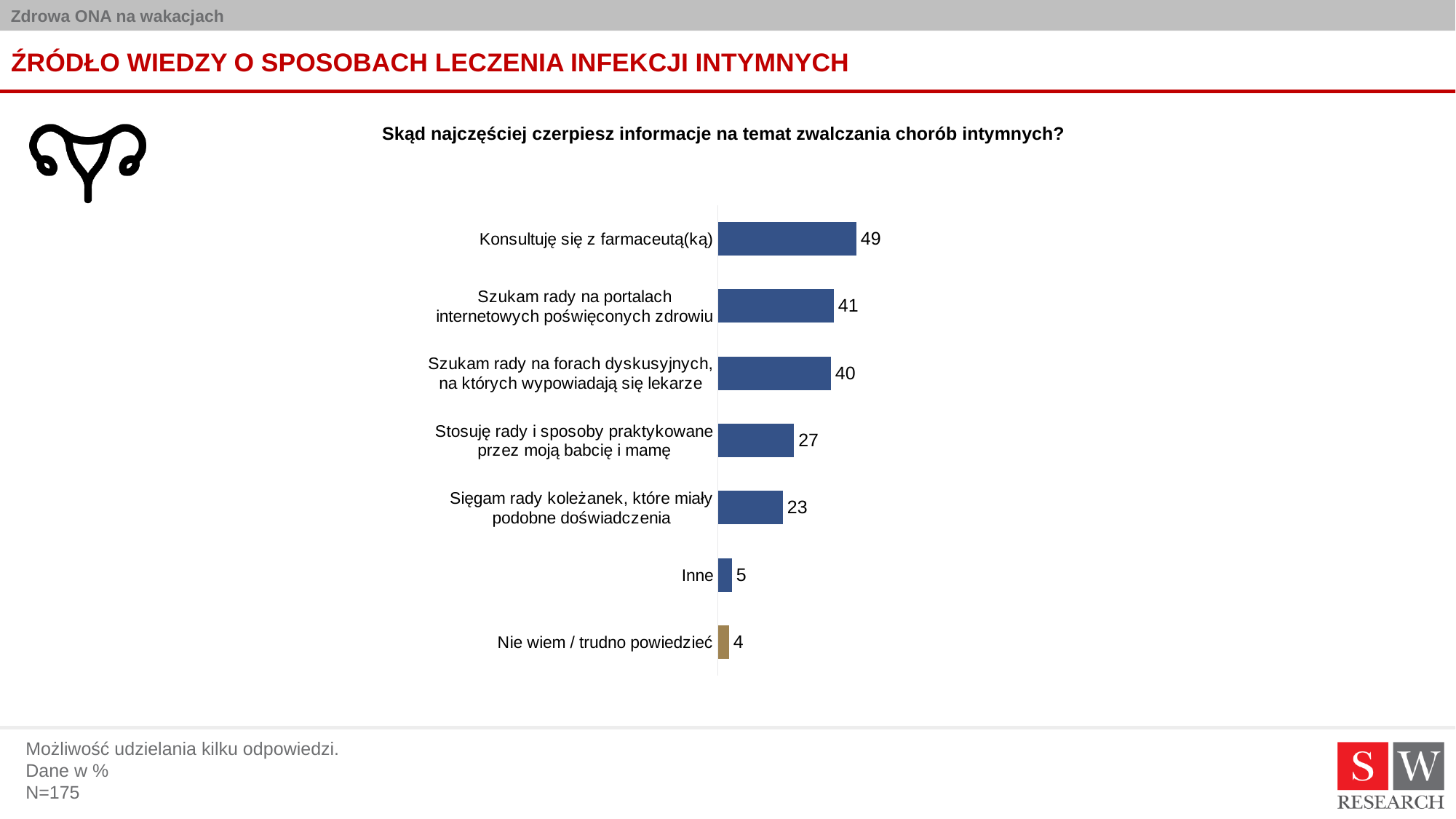
How many categories are shown in the chart? 7 What is the difference between the values for "Konsultuję się z farmaceutą(ką)" and "Szukam rady na portalach internetowych poświęconych zdrowiu"? 8 Which category's bar is shown in a different colour from the others? Nie wiem / trudno powiedzieć What value is shown for "Sięgam rady koleżanek, które miały podobne doświadczenia"? 23 Which category has the highest value? Konsultuję się z farmaceutą(ką) Which category has the lowest value? Nie wiem / trudno powiedzieć What value is shown for "Inne"? 5 Which is larger: the value for "Szukam rady na forach dyskusyjnych, na których wypowiadają się lekarze" or the value for "Stosuję rady i sposoby praktykowane przez moją babcię i mamę"? Szukam rady na forach dyskusyjnych, na których wypowiadają się lekarze What value is shown for "Stosuję rady i sposoby praktykowane przez moją babcię i mamę"? 27 What kind of chart is shown on the slide? Bar chart What is the difference between the values for "Stosuję rady i sposoby praktykowane przez moją babcię i mamę" and "Sięgam rady koleżanek, które miały podobne doświadczenia"? 4 What value is shown for "Konsultuję się z farmaceutą(ką)"? 49